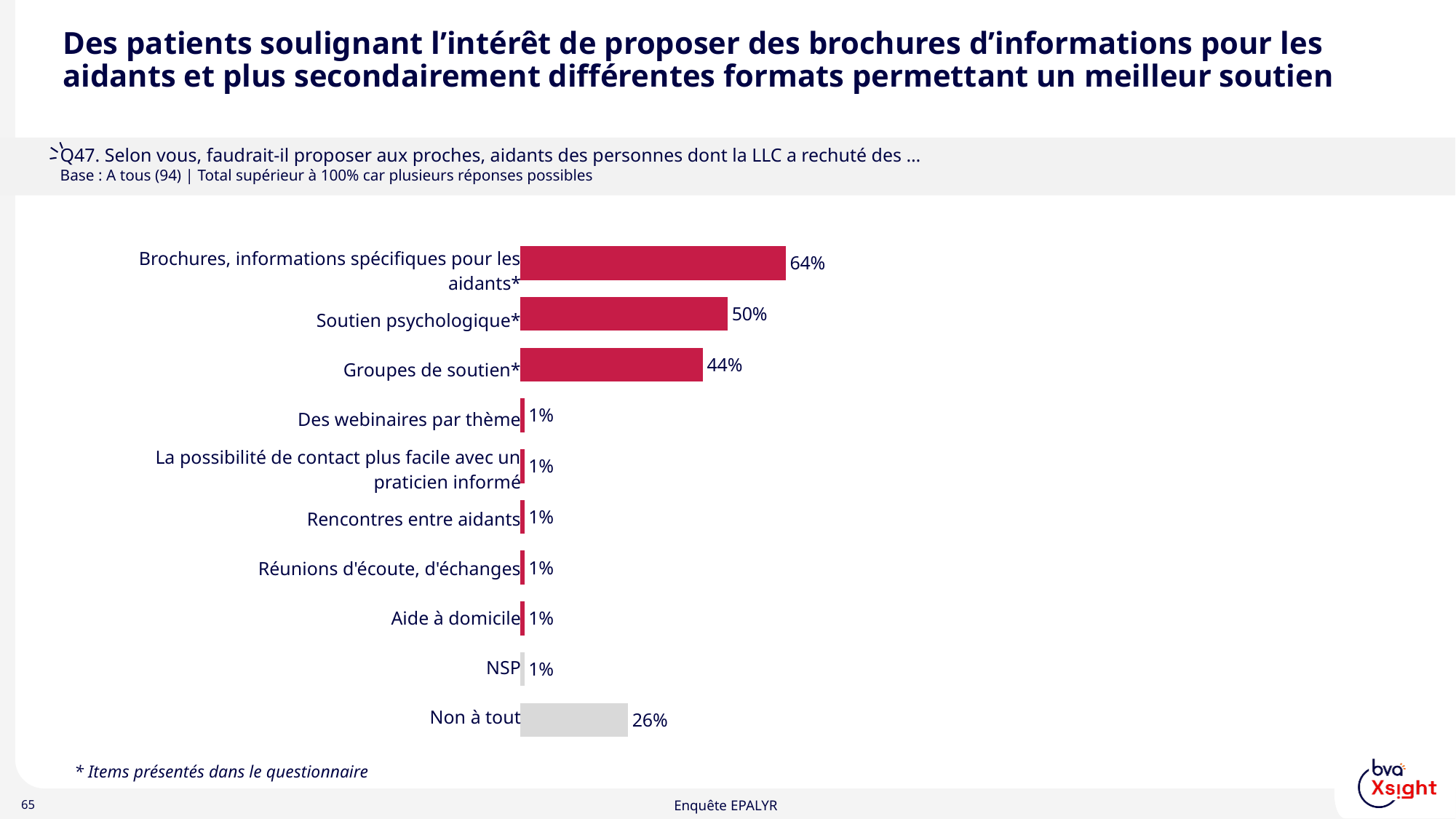
Which is larger: the value for "Groupes de soutien*" or the value for "Non à tout"? Groupes de soutien* What is the value shown for "Des webinaires par thème"? 1% What percentage is shown for "Non à tout"? 26% What is the value shown for "Groupes de soutien*"? 44% What is the value shown for "Soutien psychologique*"? 50% What is the difference between the values for "Brochures, informations spécifiques pour les aidants*" and "Soutien psychologique*"? 14% What type of chart is shown on the slide? Bar chart What colour are the bars for "NSP" and "Non à tout"? Grey How many categories are shown in the chart? 10 Which category has the highest value in the chart? Brochures, informations spécifiques pour les aidants* What percentage of respondents chose "Brochures, informations spécifiques pour les aidants*"? 64% What is the difference between the values for "Soutien psychologique*" and "Groupes de soutien*"? 6%